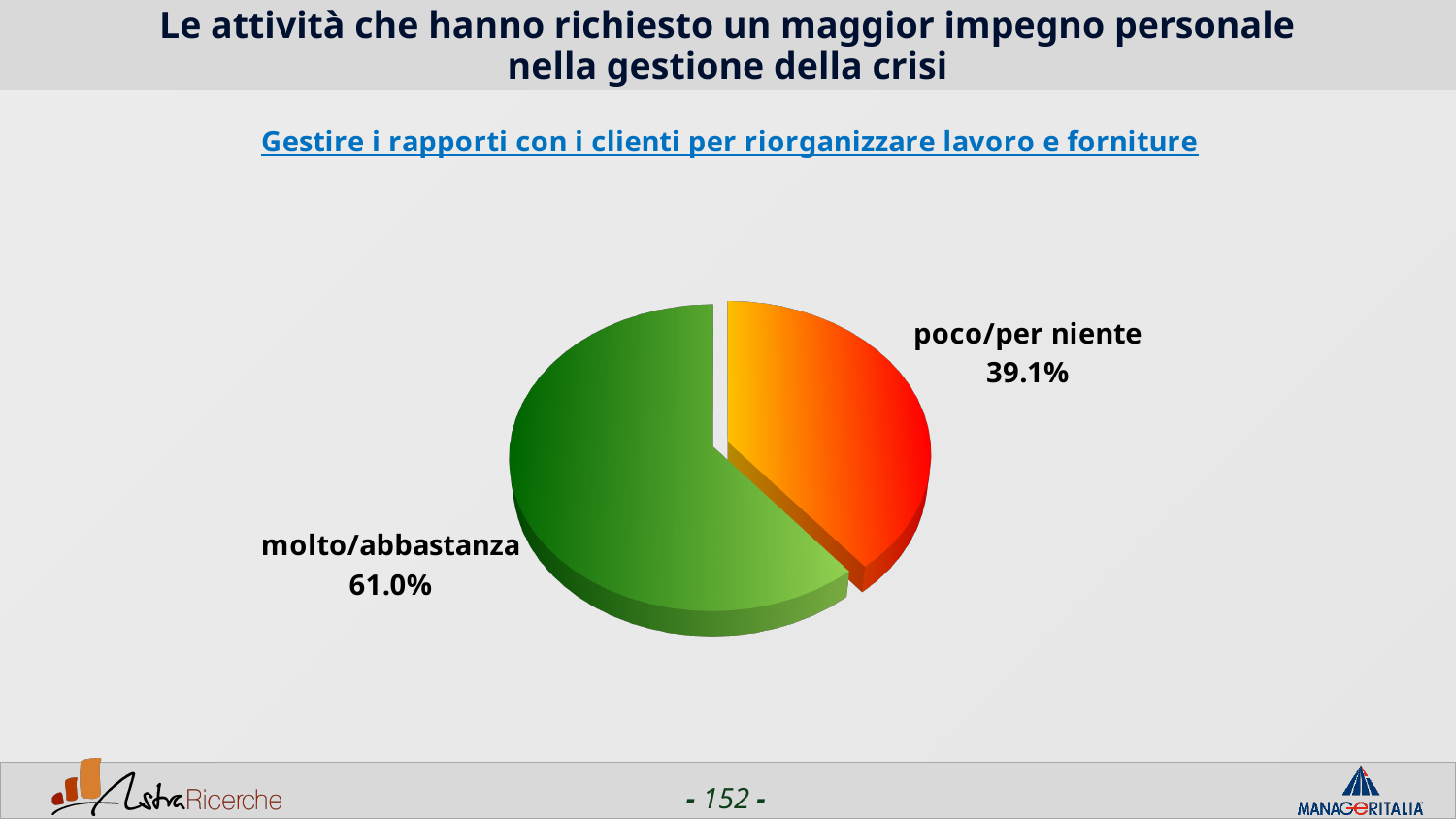
What is the difference between the "molto/abbastanza" and "poco/per niente" values? 21.9% Which slice is the largest? molto/abbastanza What colour is the "molto/abbastanza" slice? green What is the value for "molto/abbastanza"? 61.0% What is the value for "poco/per niente"? 39.1% Which slice is the smallest? poco/per niente What kind of chart is shown on the slide? pie chart Which is larger, "molto/abbastanza" or "poco/per niente"? molto/abbastanza What share of the pie does "poco/per niente" represent? 39.1% How many slices does the pie chart have? 2 What is the subtitle of the chart shown in blue text? Gestire i rapporti con i clienti per riorganizzare lavoro e forniture